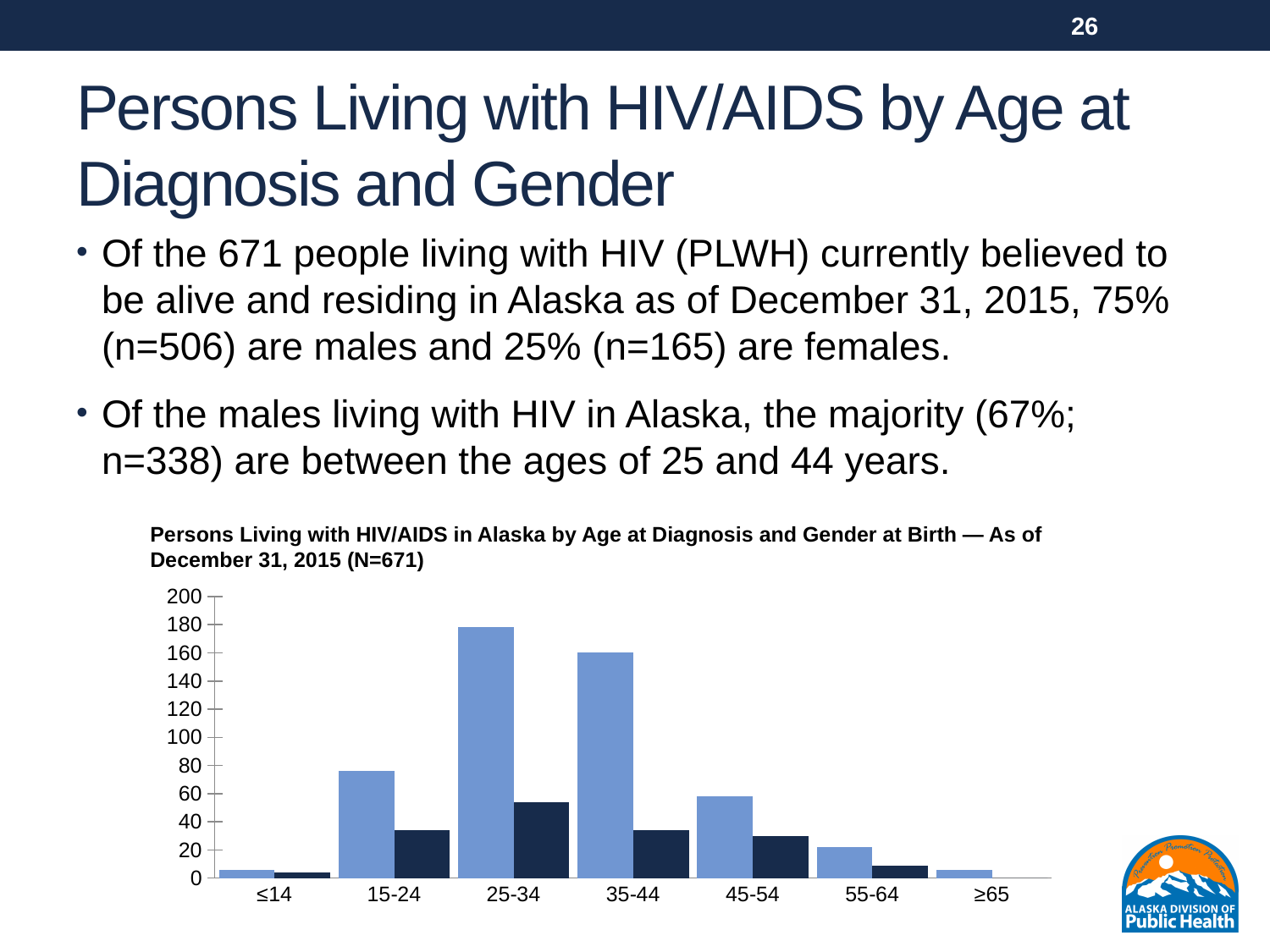
How many age categories are shown on the x axis of the chart? 7 Which age category has the tallest light blue bar? 25-34 Which is larger, the light blue bar for 15-24 or the light blue bar for 45-54? 15-24 Is the light blue bar for 25-34 greater or less than 160? greater Which age category has the tallest dark blue bar? 25-34 Is the light blue bar for 55-64 greater or less than 40? less Do the light blue bars rise or fall from the 25-34 category to the ≥65 category? Fall Which is larger, the light blue bar for 25-34 or the light blue bar for 35-44? 25-34 Is the light blue bar for 15-24 greater or less than 100? less What is the highest value shown on the chart's vertical axis? 200 What kind of chart is shown on the slide? Bar chart